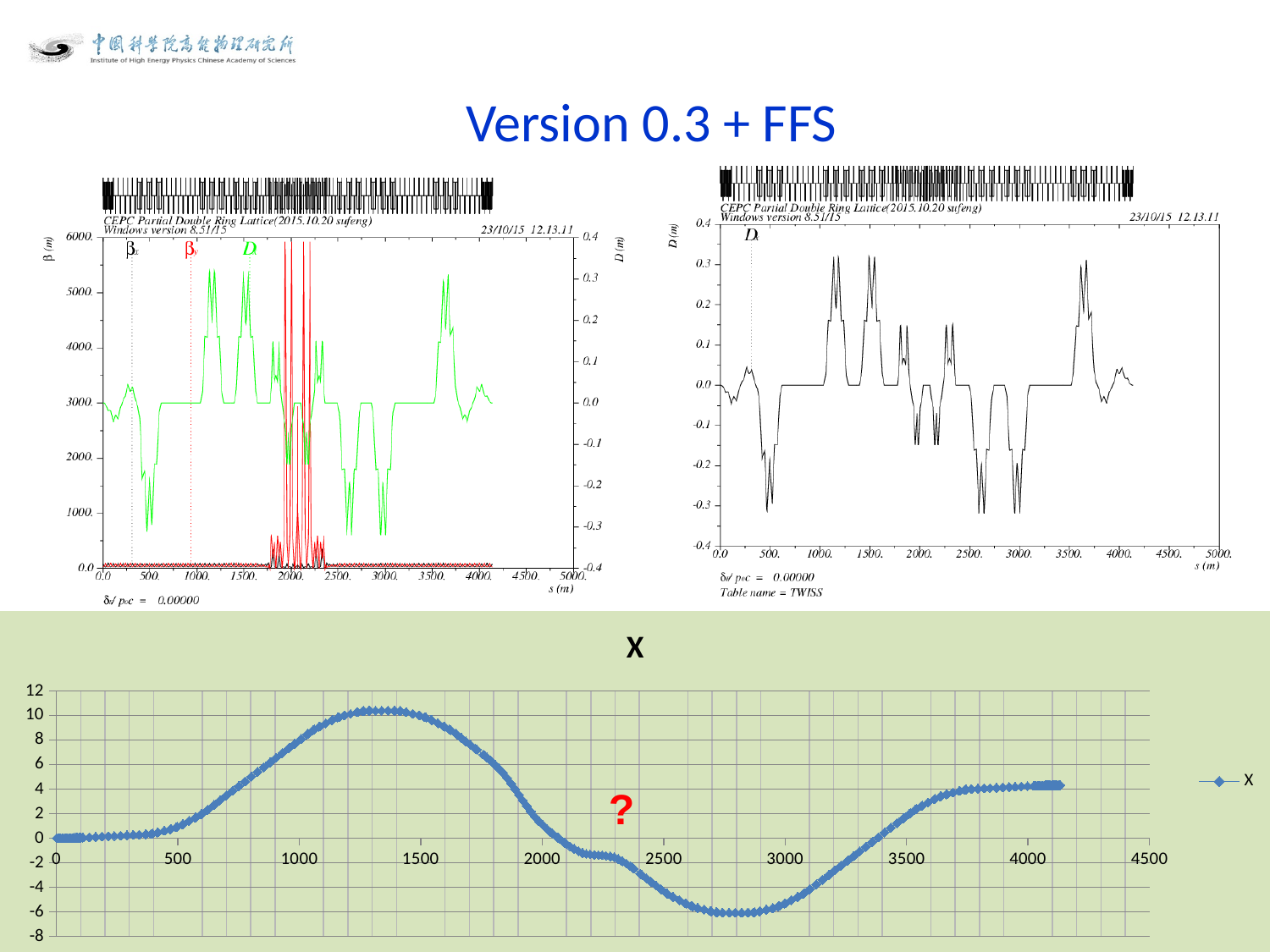
In the bottom chart titled "X", is the value of the series at x=4000 greater or less than 2? greater What kind of chart is the bottom chart titled "X"? line chart In the bottom chart titled "X", do the values rise or fall as x goes from 3000 to 3700? rise In the top-left chart, how many series are labelled (βx, βy, Dx)? 3 In the bottom chart titled "X", which is larger: the value of the series at x=1300 or at x=4000? x=1300 In the bottom chart titled "X", do the values rise or fall as x goes from 1500 to 2750? fall In the bottom chart titled "X", what is the name of the series shown in the legend? X In the bottom chart titled "X", what is the highest tick value shown on the vertical axis? 12 In the top-right chart (Dx versus s), is the peak value near s=1200 greater or less than 0.2? greater In the bottom chart titled "X", how many series does the legend list? 1 In the bottom chart titled "X", is the peak value of the series near x=1300 greater or less than 8? greater